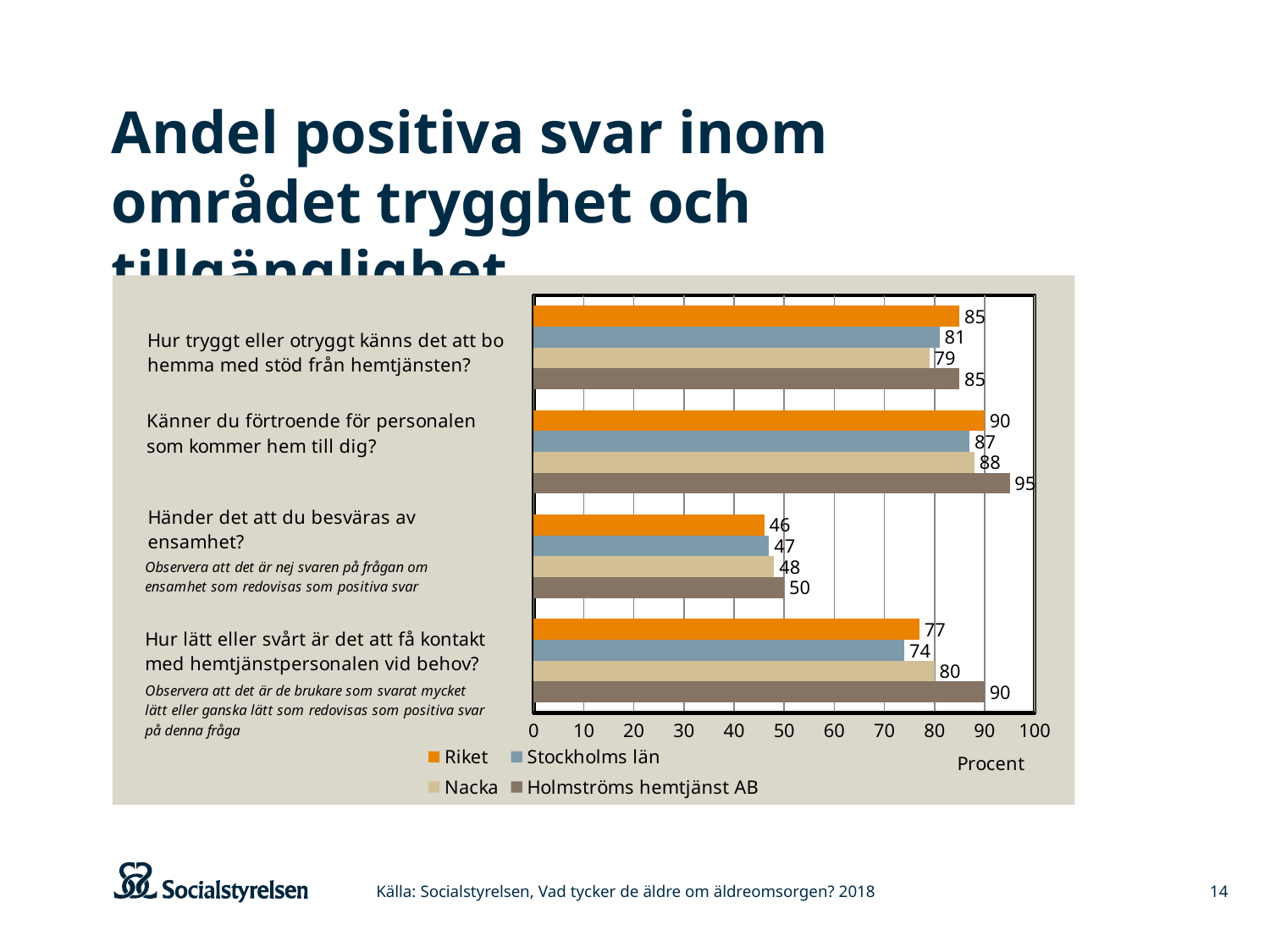
What is the value for Nacka on the question "Hur tryggt eller otryggt känns det att bo hemma med stöd från hemtjänsten?"? 79 What is the value for Riket on the question "Känner du förtroende för personalen som kommer hem till dig?"? 90 What is the value for Stockholms län on the question "Händer det att du besväras av ensamhet?"? 47 Which series has the highest value on the question "Känner du förtroende för personalen som kommer hem till dig?"? Holmströms hemtjänst AB How many series does the legend list? 4 Which series has the lowest value on the question "Hur lätt eller svårt är det att få kontakt med hemtjänstpersonalen vid behov?"? Stockholms län How many question categories are shown on the chart? 4 What is the difference between Holmströms hemtjänst AB and Riket on the question "Hur lätt eller svårt är det att få kontakt med hemtjänstpersonalen vid behov?"? 13 What kind of chart is shown on the slide? Bar chart What is the value for Holmströms hemtjänst AB on the question "Hur lätt eller svårt är det att få kontakt med hemtjänstpersonalen vid behov?"? 90 What label is shown on the horizontal axis of the chart? Procent Which is larger on the question "Hur tryggt eller otryggt känns det att bo hemma med stöd från hemtjänsten?": Stockholms län or Nacka? Stockholms län